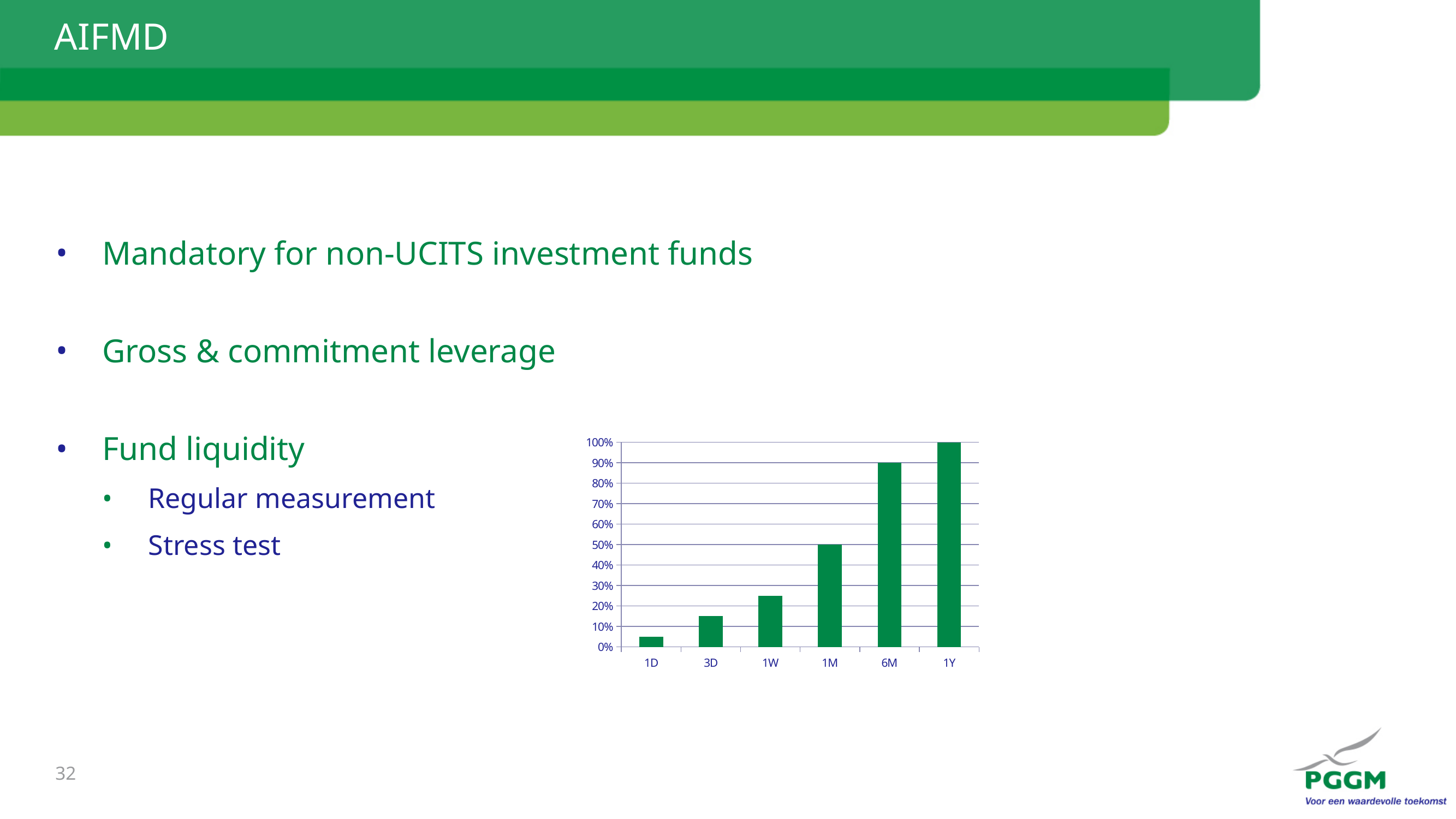
Do the values rise or fall from 1D to 1Y along the x axis? rise Is the value for 1D greater or less than 10%? less What is the value for 1M in the chart? 50% Is the value for 1W greater or less than 20%? greater What is the difference between the values for 1Y and 6M? 10% Which category has the highest value in the chart? 1Y What kind of chart is shown on the slide? bar chart What is the value for 1Y in the chart? 100% What is the difference between the values for 6M and 1M? 40% How many categories are shown on the x axis of the chart? 6 What is the value for 6M in the chart? 90% Which category has the lowest value in the chart? 1D